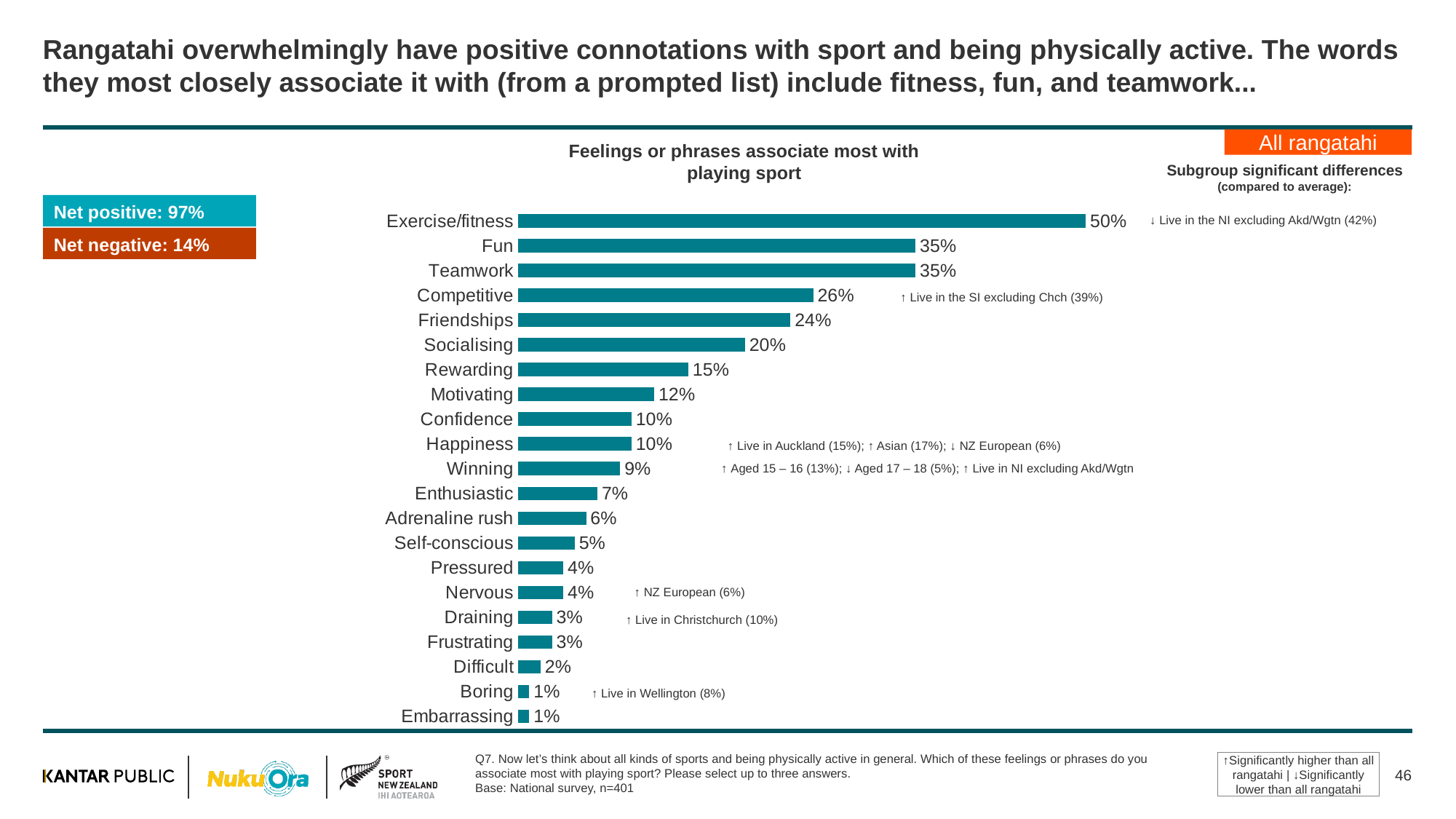
What is the value shown for Self-conscious? 5% Which has a larger value, Rewarding or Motivating? Rewarding What is the value shown for Socialising? 20% What percentage of rangatahi associate Exercise/fitness with playing sport? 50% What is the Net positive figure shown on the slide? 97% How many feelings or phrases are listed in the chart? 21 What is the title of the chart? Feelings or phrases associate most with playing sport Which feeling or phrase has the highest value in the chart? Exercise/fitness What is the difference between the values for Competitive and Friendships? 2% What is the difference between the values for Exercise/fitness and Fun? 15% What type of chart is shown on the slide? Bar chart Which has a larger value, Enthusiastic or Adrenaline rush? Enthusiastic